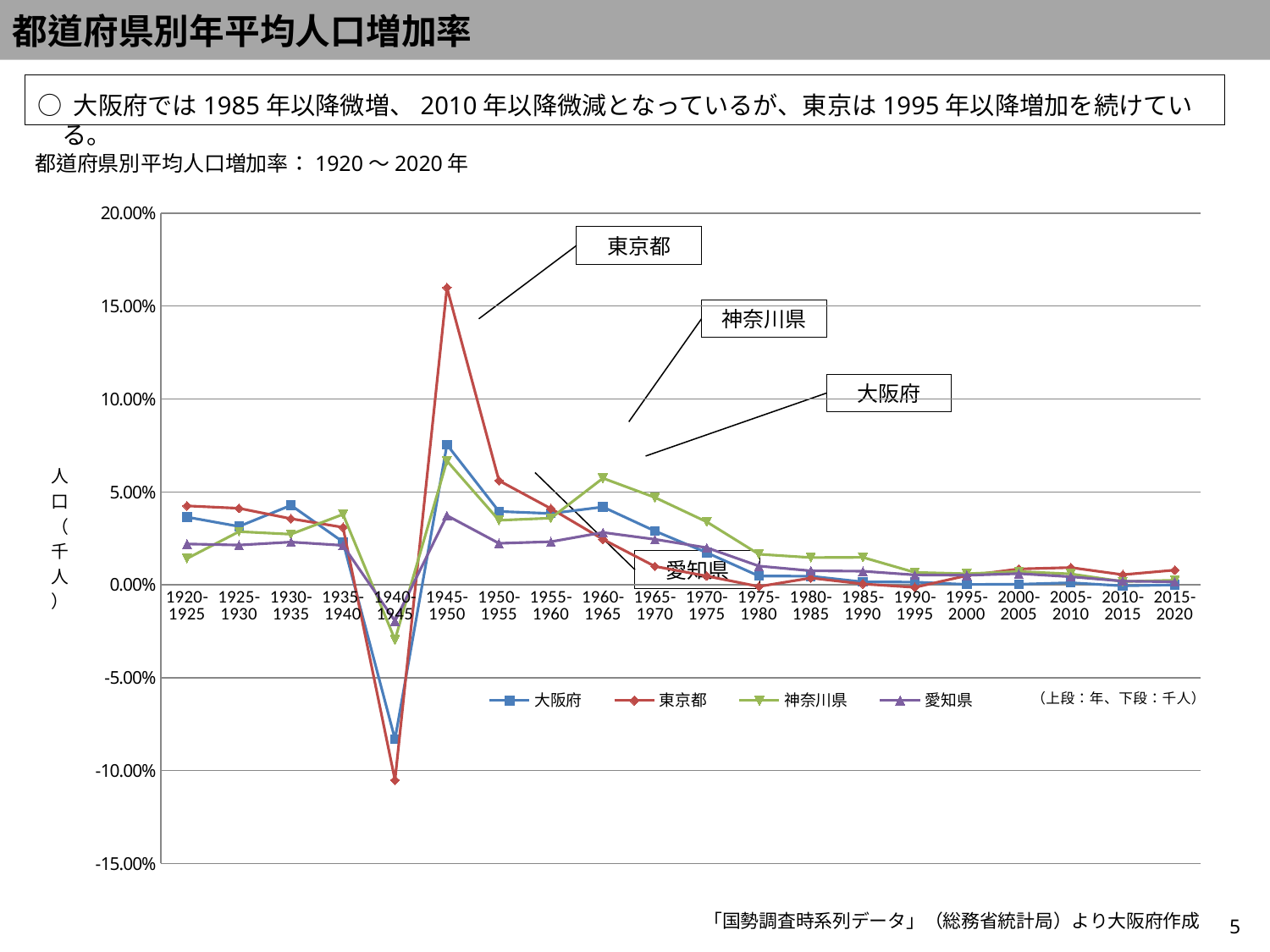
In which period does 東京都 reach its highest value? 1945-1950 How many series does the legend list? 4 Which series has the highest value in the 1945-1950 period? 東京都 How many periods are shown along the x axis? 20 Is the value for 東京都 in 1945-1950 greater or less than 15.00%? greater What kind of chart is shown on the slide? line chart Which series has the lowest value in the 1940-1945 period? 東京都 Does the value for 東京都 rise or fall from 1945-1950 to 1975-1980? fall Is the value for 大阪府 in 1940-1945 greater or less than -5.00%? less What is the title of the chart? 都道府県別平均人口増加率：1920～2020年 In the 1960-1965 period, which is larger: the value for 神奈川県 or the value for 大阪府? 神奈川県 In which period does 大阪府 reach its lowest value? 1940-1945